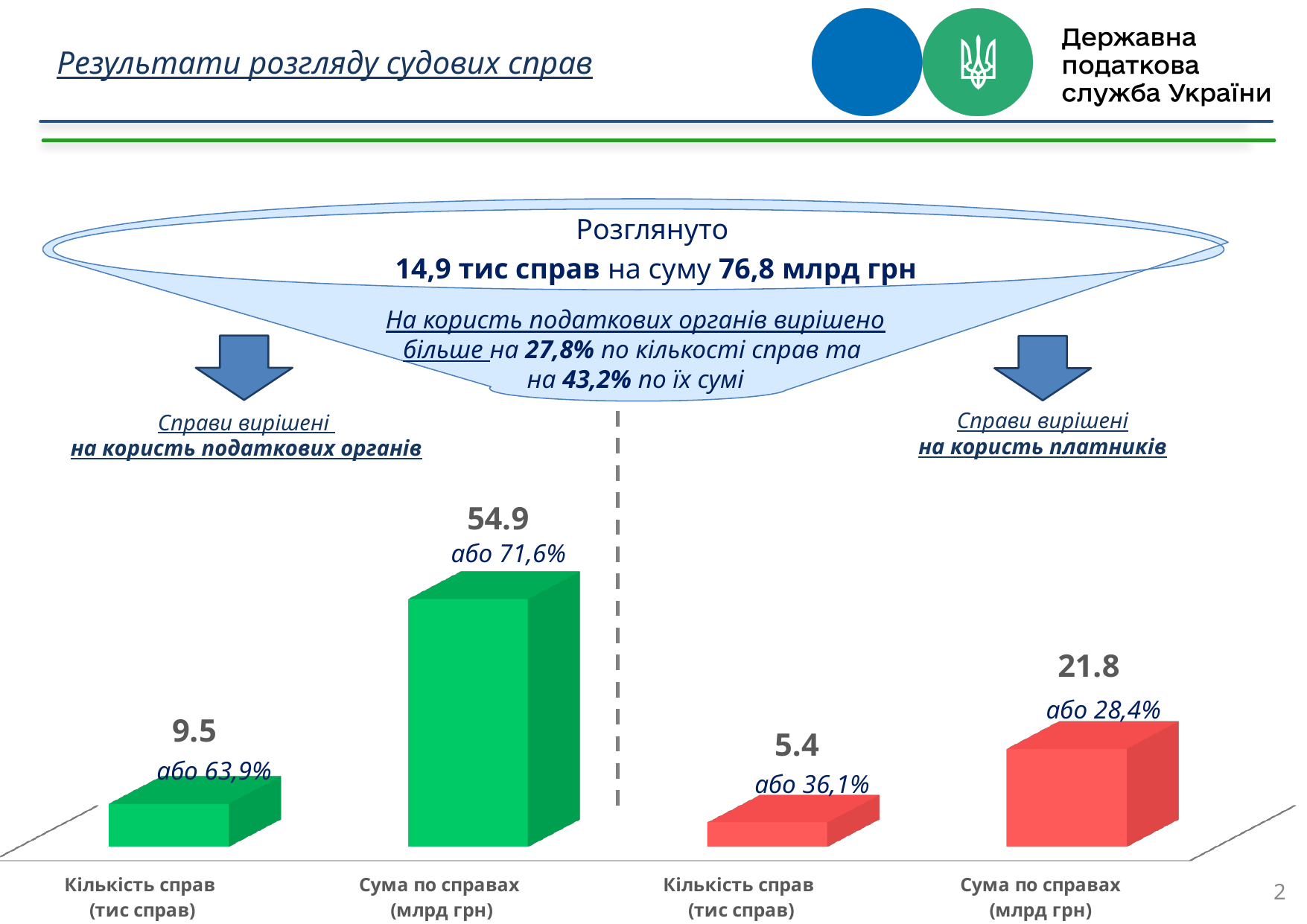
Which is larger: the number of cases decided in favour of tax authorities or in favour of taxpayers? In favour of tax authorities (9.5) What is the value of the bar for 'Сума по справах (млрд грн)' decided in favour of tax authorities? 54.9 Which bar has the highest value on the chart? Сума по справах (млрд грн) на користь податкових органів, 54.9 What is the value of the bar for 'Сума по справах (млрд грн)' decided in favour of taxpayers? 21.8 What is the value of the bar for 'Кількість справ (тис справ)' decided in favour of tax authorities (на користь податкових органів)? 9.5 What colour are the bars for cases decided in favour of taxpayers? Red What is the value of the bar for 'Кількість справ (тис справ)' decided in favour of taxpayers (на користь платників)? 5.4 Which bar has the lowest value on the chart? Кількість справ (тис справ) на користь платників, 5.4 How many bars are plotted on the chart? 4 What type of chart is shown on the slide? Bar chart What is the difference between the number of cases decided in favour of tax authorities (9.5) and in favour of taxpayers (5.4)? 4.1 What is the difference between the sum of cases decided in favour of tax authorities (54.9) and in favour of taxpayers (21.8)? 33.1